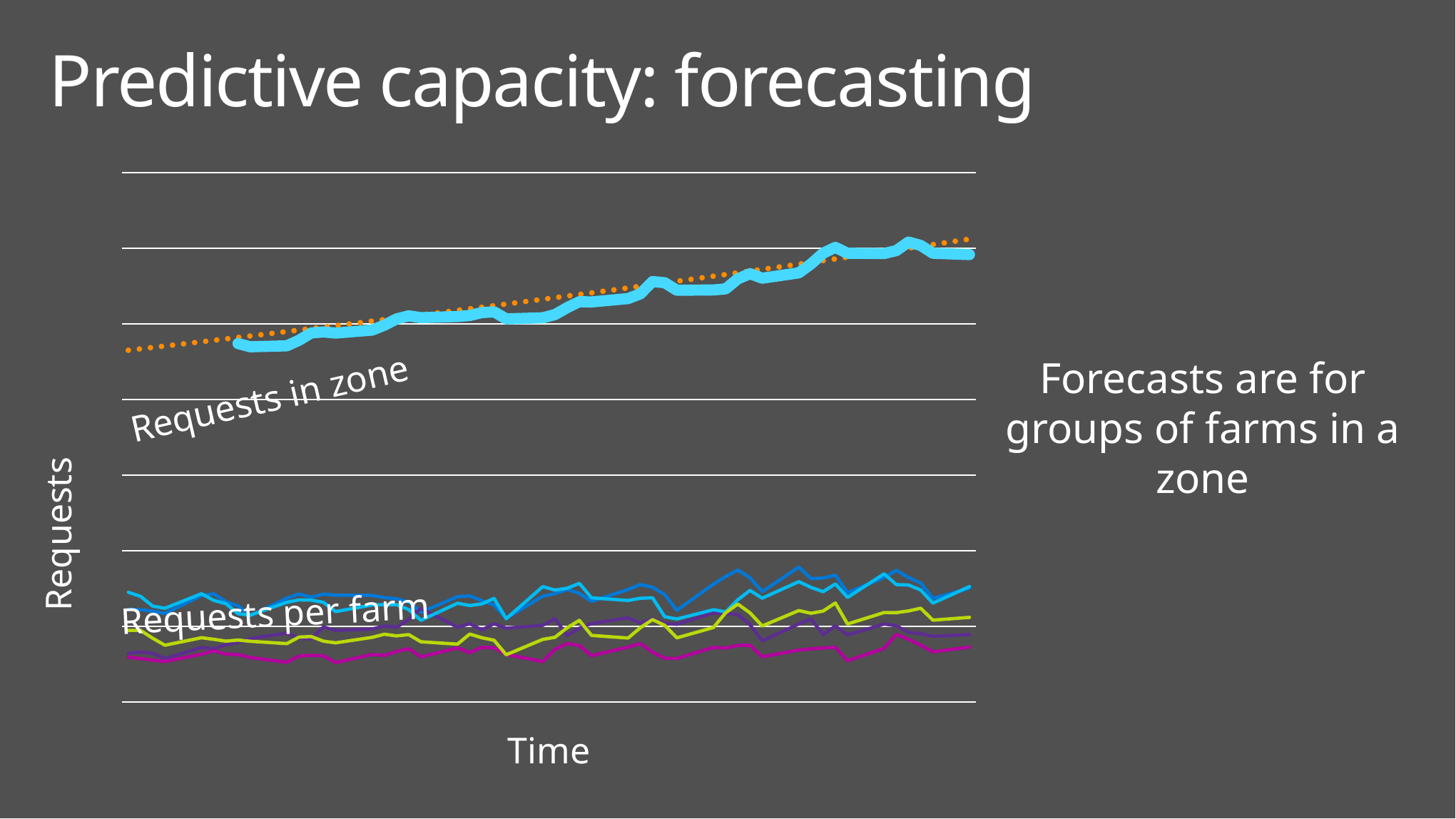
What is the label on the vertical axis of the chart? Requests What is the title of the slide containing the chart? Predictive capacity: forecasting What style of line accompanies the thick 'Requests in zone' line? a dotted line Which group of lines sits lowest on the chart? Requests per farm What are the two labelled groups of lines on the chart? Requests in zone; Requests per farm What is the label on the horizontal axis of the chart? Time Which group of lines sits higher on the chart, 'Requests in zone' or 'Requests per farm'? Requests in zone Does the 'Requests in zone' line rise or fall as time moves along the x axis? rise What kind of chart is shown on the slide? line chart